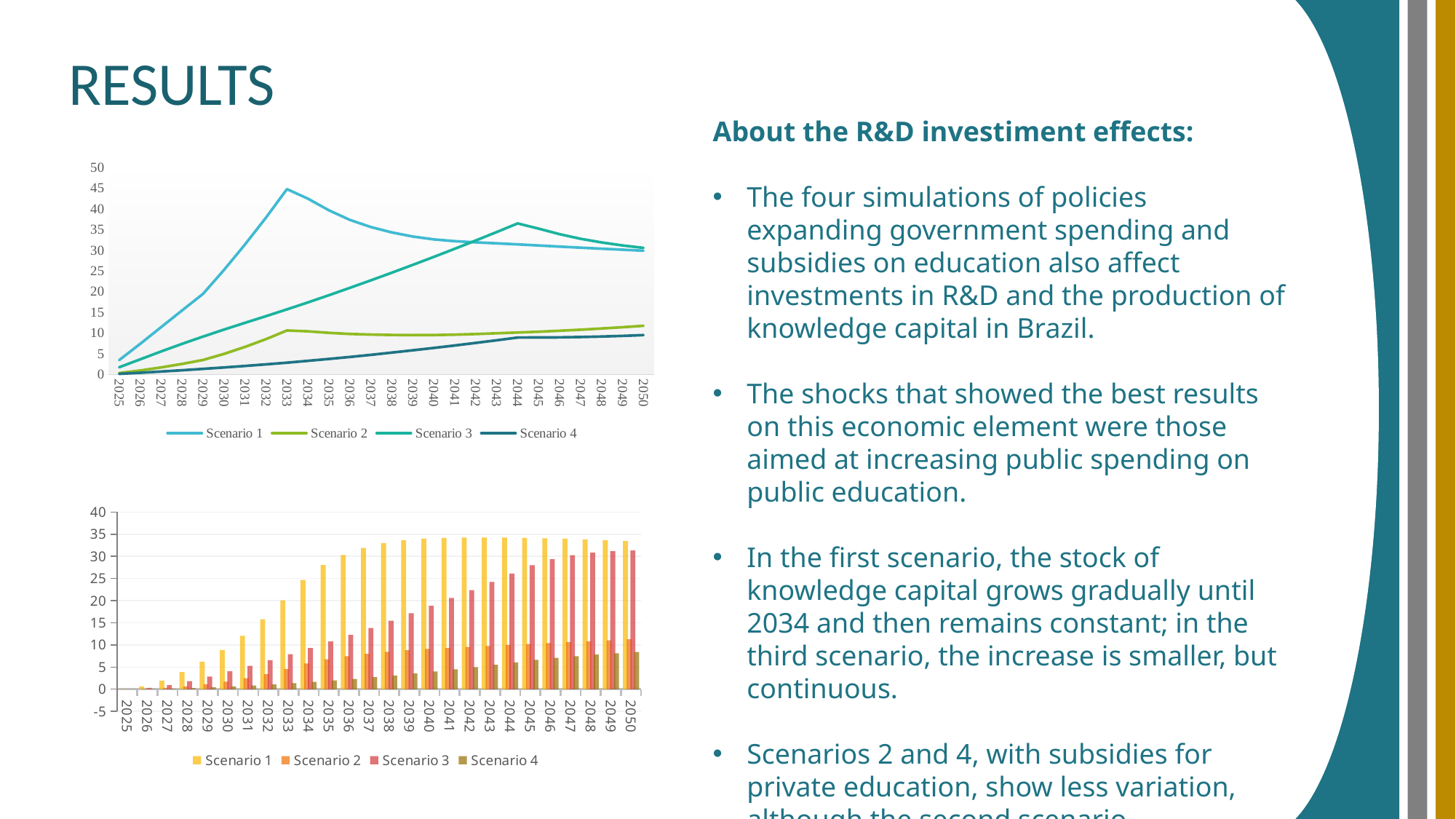
In the top chart, which scenario reaches the highest value at any point? Scenario 1 In the top chart, is the value for Scenario 1 in 2033 greater or less than 40? greater What kind of chart is the bottom chart on the slide? bar chart What kind of chart is the top chart on the slide? line chart In the top chart, is the value for Scenario 3 in 2044 greater or less than 30? greater How many series does the legend of the bottom chart list? 4 How many years are shown on the x axis of the top chart? 26 In the top chart, in which year does Scenario 1 reach its peak? 2033 How many series does the legend of the top chart list? 4 In the bottom chart, is the value for Scenario 1 in 2050 greater or less than 30? greater In the top chart, does Scenario 4 rise or fall from 2025 to 2050? rise In the bottom chart, which is larger in 2040, Scenario 1 or Scenario 3? Scenario 1